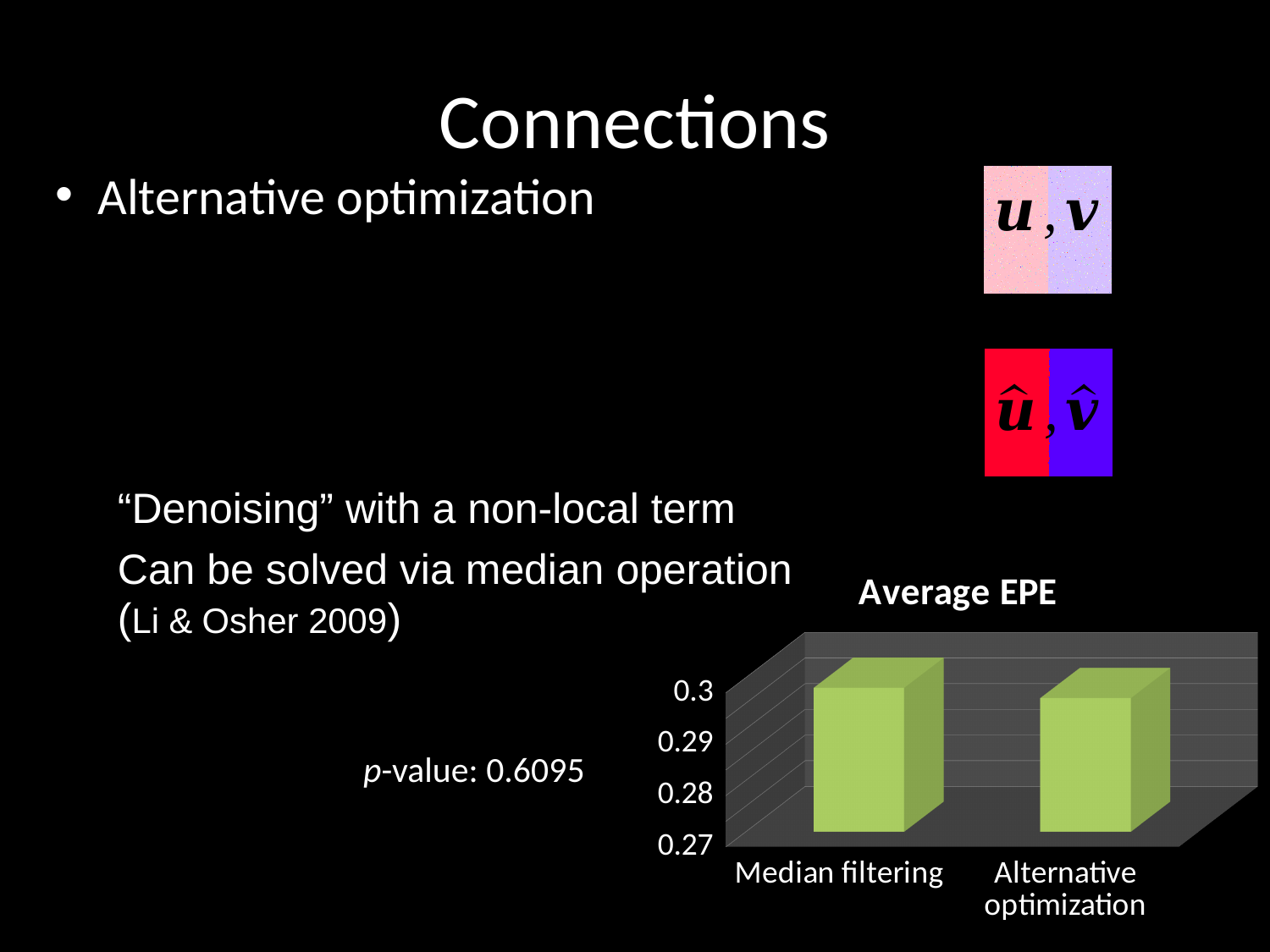
What is the lowest tick value shown on the vertical axis of the Average EPE chart? 0.27 In the Average EPE chart, is the value for Alternative optimization greater or less than 0.28? greater In the Average EPE chart, is the value for Alternative optimization greater or less than 0.27? greater What kind of chart is shown on the slide? Bar chart What is the title of the chart on the slide? Average EPE What are the two categories shown on the x axis of the Average EPE chart? Median filtering and Alternative optimization How many categories are plotted in the Average EPE chart? 2 In the Average EPE chart, is the value for Median filtering greater or less than 0.28? greater